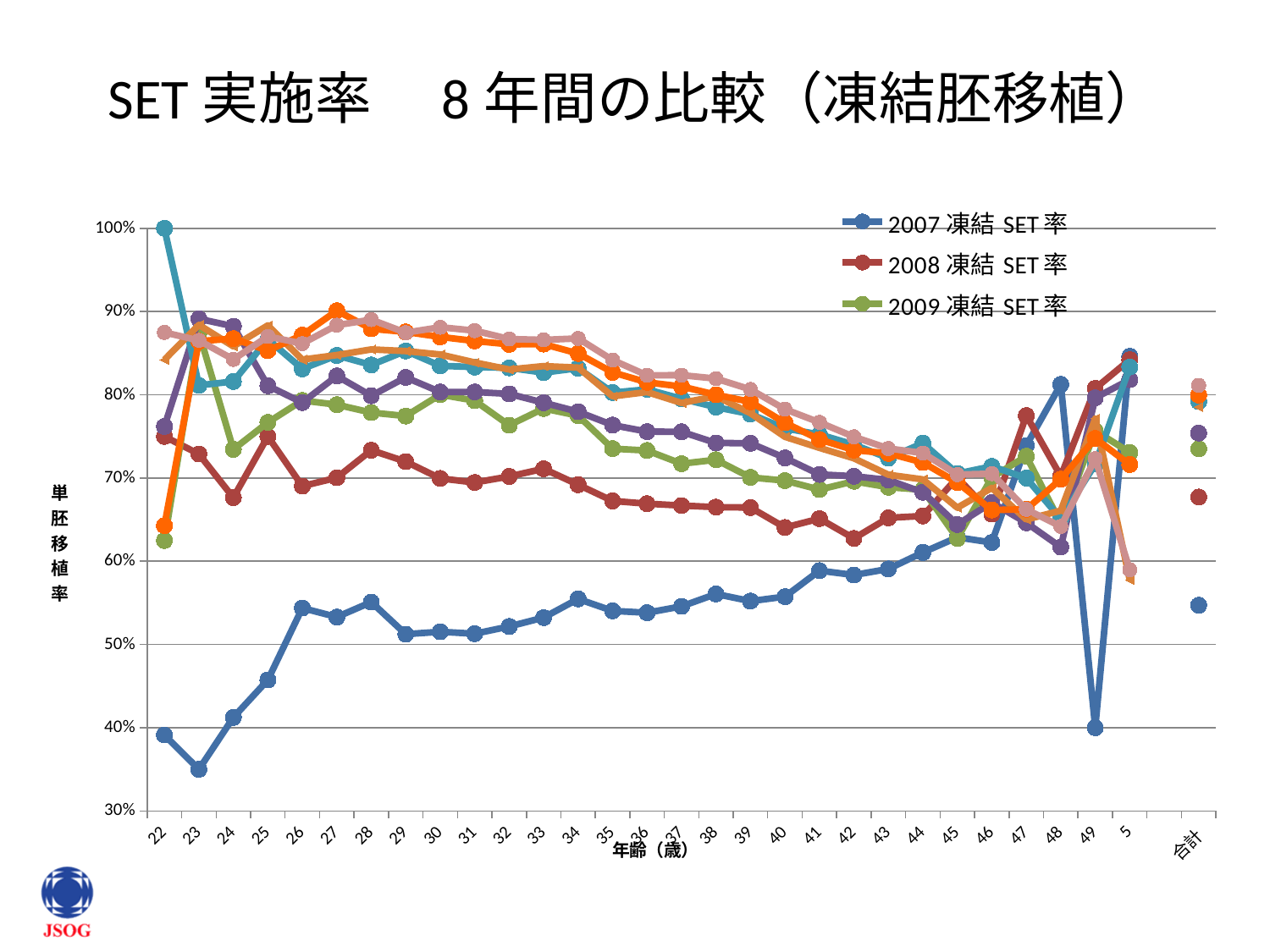
What kind of chart is shown on the slide? line chart How many series does the legend list? 3 What is the title of the chart on the slide? SET 実施率 8 年間の比較（凍結胚移植） Does the 2007 凍結 SET 率 series generally rise or fall from age 23 to age 48? rise Is the value of the 2007 凍結 SET 率 series at age 23 greater or less than 40%? less What is the label of the x axis? 年齢（歳） Is the 合計 value of the 2008 凍結 SET 率 series greater or less than 70%? less Is the value of the 2009 凍結 SET 率 series at age 22 greater or less than 60%? greater At age 30, which series has the higher value: 2007 凍結 SET 率 or 2008 凍結 SET 率? 2008 凍結 SET 率 For the 2007 凍結 SET 率 series, at which age is the value lowest? 23